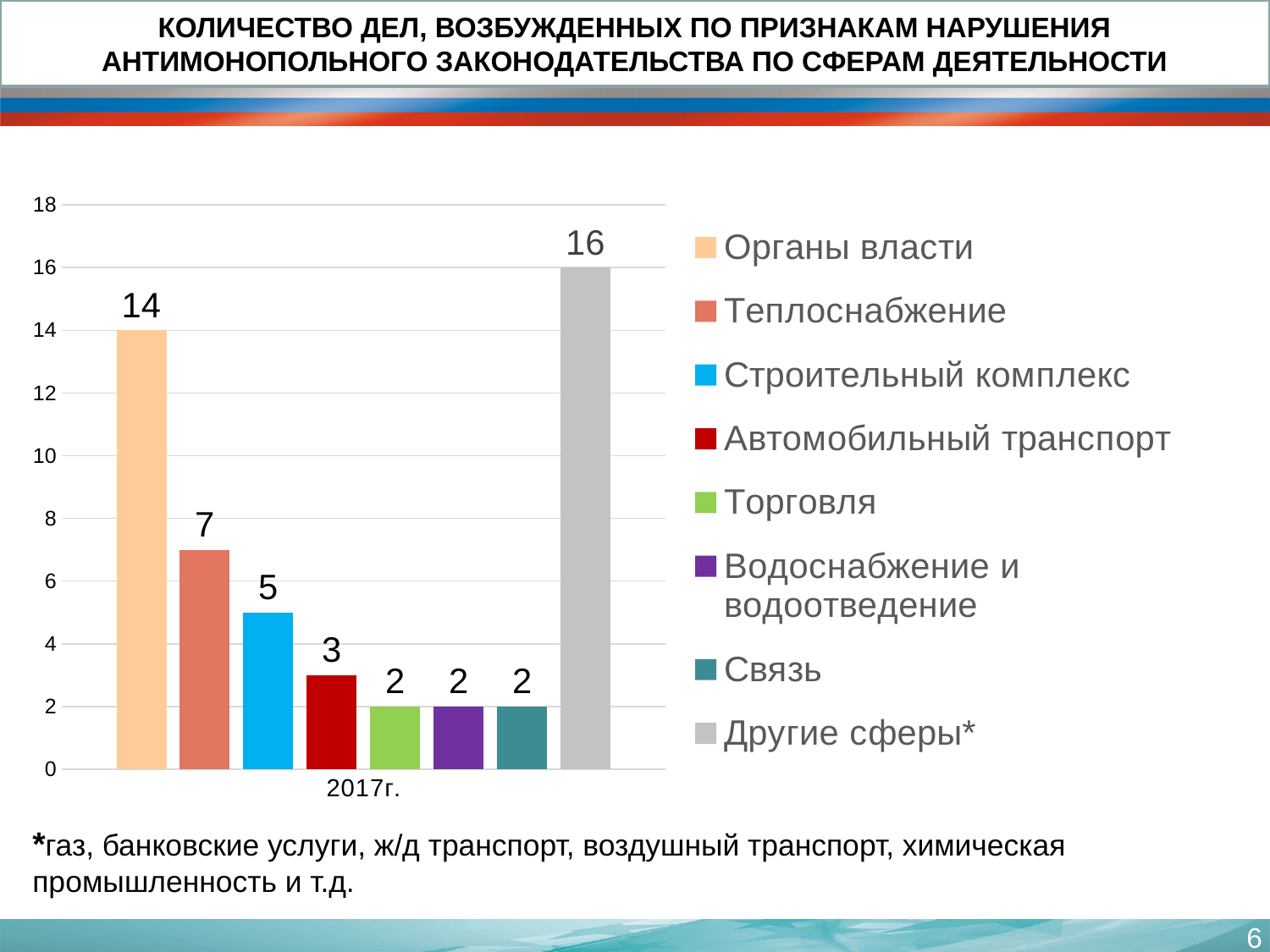
What is the difference between the values for Органы власти and Теплоснабжение? 7 How many series does the legend list? 8 What is the value for Связь? 2 What is the value for Строительный комплекс? 5 Which series has the highest value? Другие сферы* What is the difference between the values for Другие сферы* and Органы власти? 2 What is the value for Органы власти? 14 What is the value for Автомобильный транспорт? 3 What year label is shown on the x axis? 2017г. What is the value for Теплоснабжение? 7 Which is larger, the value for Теплоснабжение or the value for Строительный комплекс? Теплоснабжение What kind of chart is shown on the slide? bar chart